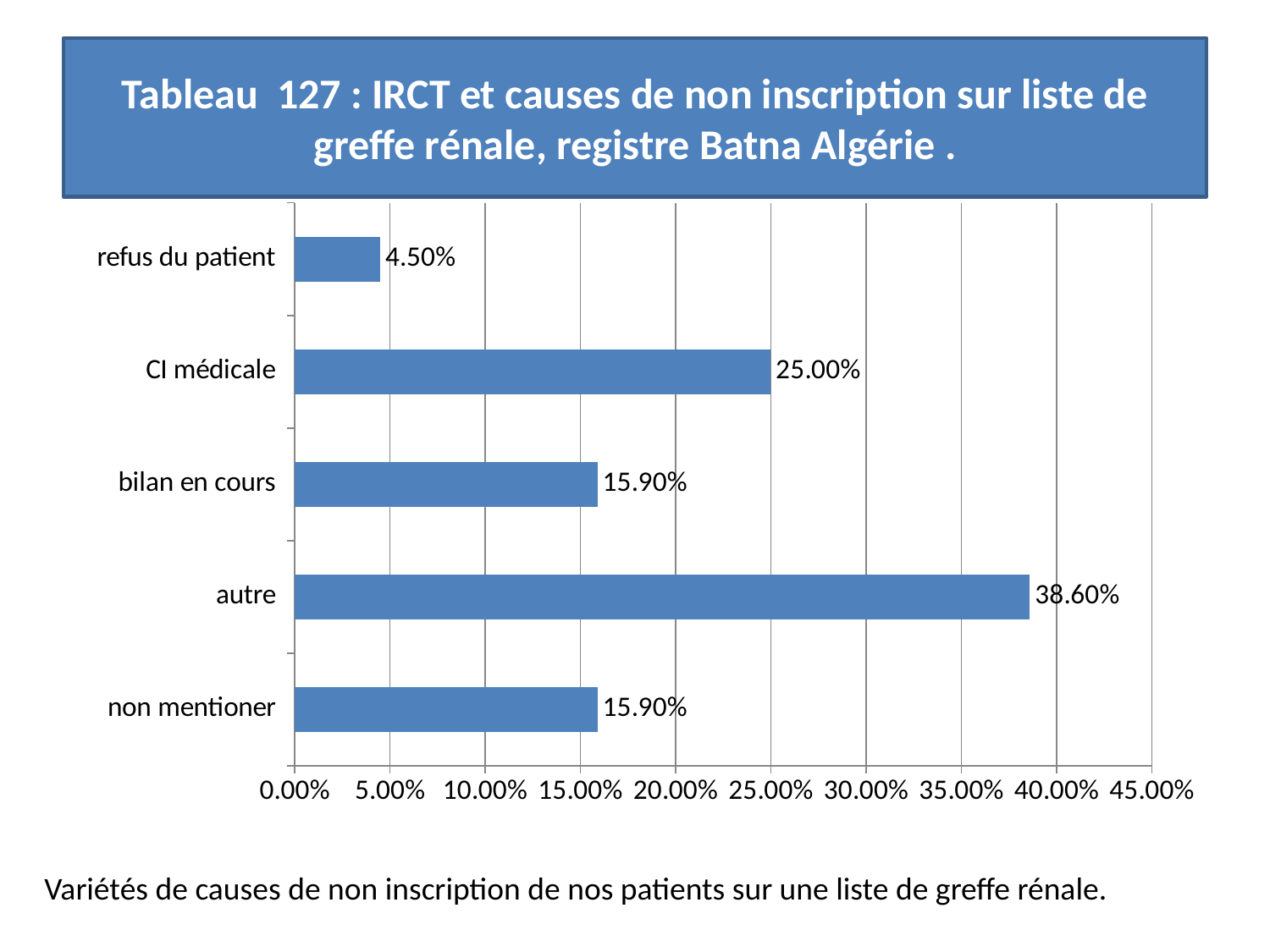
What is the value for "bilan en cours"? 15.90% Which category has the highest value? autre What is the maximum value shown on the horizontal axis? 45.00% What is the value for "autre"? 38.60% Is the value for "autre" greater or less than 35.00%? greater What is the difference between the values for "autre" and "CI médicale"? 13.60% Which is larger, the value for "CI médicale" or the value for "bilan en cours"? CI médicale What kind of chart is shown on the slide? bar chart What is the value for "CI médicale"? 25.00% How many categories are shown in the chart? 5 What is the value for "refus du patient"? 4.50% Which category has the lowest value? refus du patient